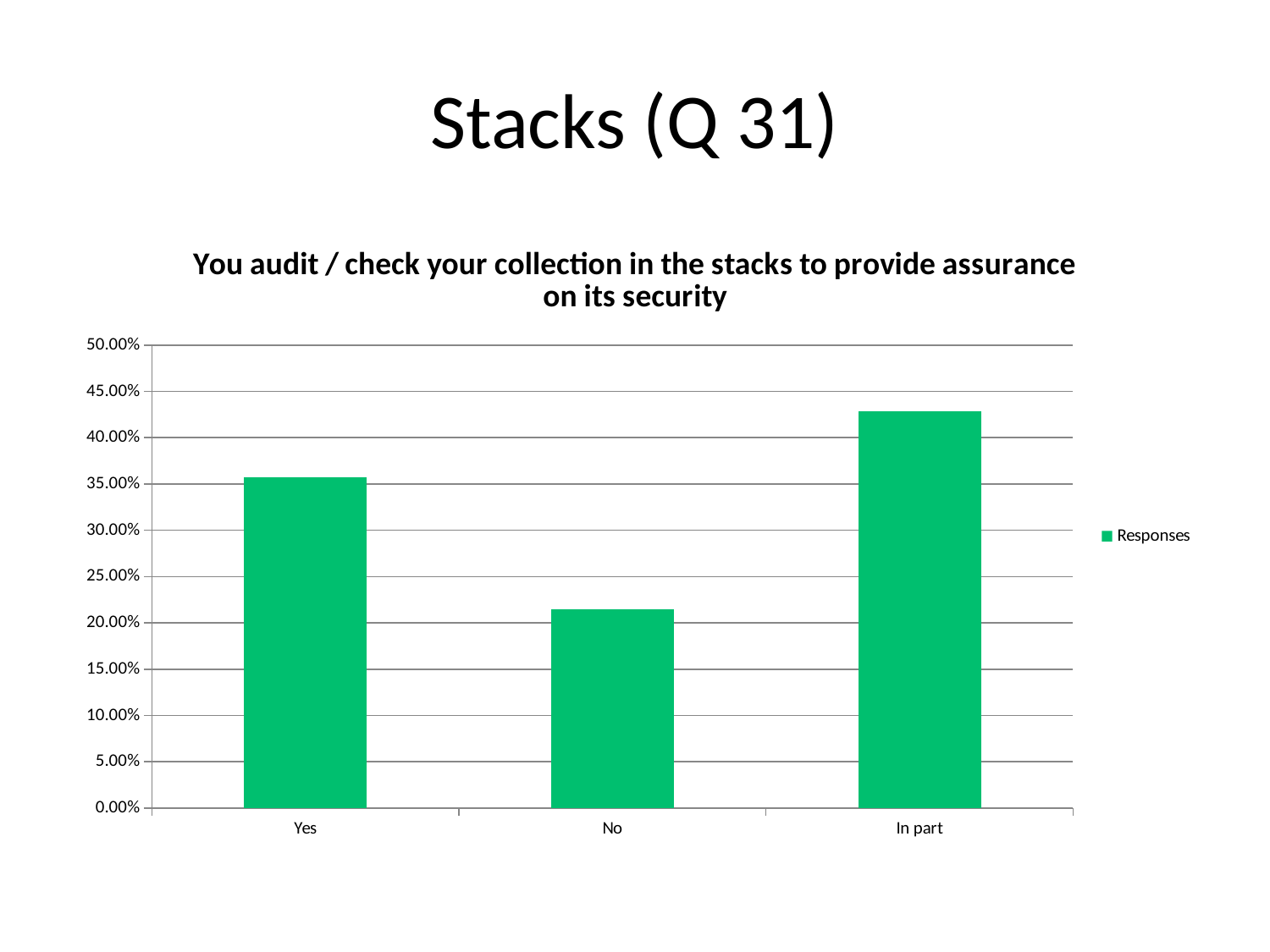
How many series does the legend list? 1 Is the value for No greater or less than 25.00%? less Is the value for Yes greater or less than 30.00%? greater Which category has the highest value? In part Which is larger, the value for Yes or the value for In part? In part Is the value for Yes greater or less than 40.00%? less How many categories are shown on the x axis of the chart? 3 What is the name of the series shown in the legend? Responses What kind of chart is shown on the slide? bar chart Which category has the lowest value? No Which is larger, the value for Yes or the value for No? Yes